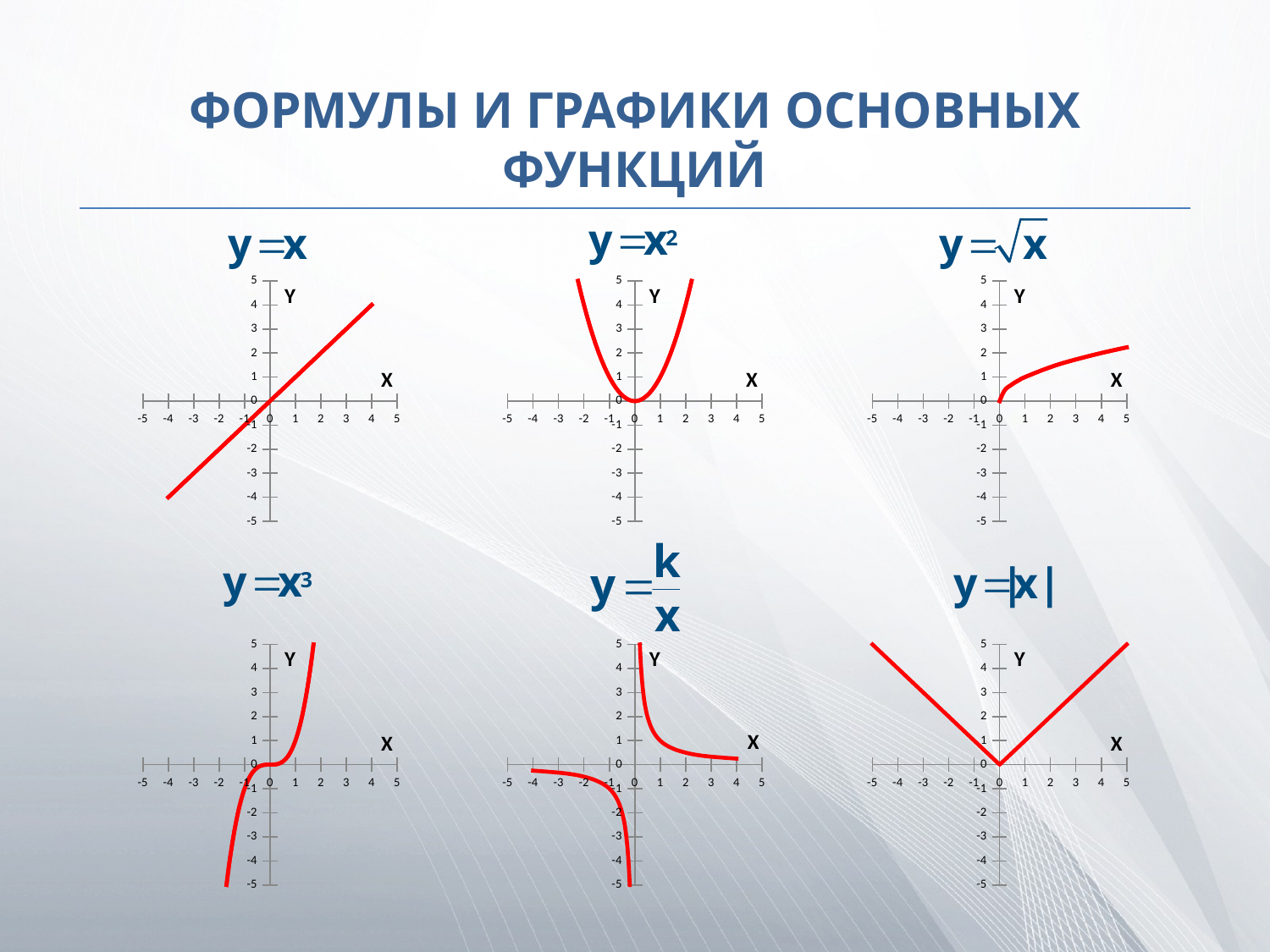
On the y=k/x chart, does the curve rise or fall as x increases from 1 to 4? fall On the y=x³ chart, does the curve rise or fall as x increases? rise On the y=|x| chart, which is larger: the value at x=-4 or the value at x=1? the value at x=-4 How many function graphs are shown on the slide? 6 On the y=x chart, does the value of y rise or fall as x increases? rise On the y=x chart, what is the value of y at x=0? 0 On the y=x² chart, at which x value is the curve lowest? 0 On the y=√x chart, is the value at x=4 greater or less than 3? less What is the range of the x axis on each chart? -5 to 5 What colour are the function curves drawn in? red On the y=x² chart, is the value at x=2 greater or less than 3? greater What kind of chart is used for each of the six graphs on the slide? line chart